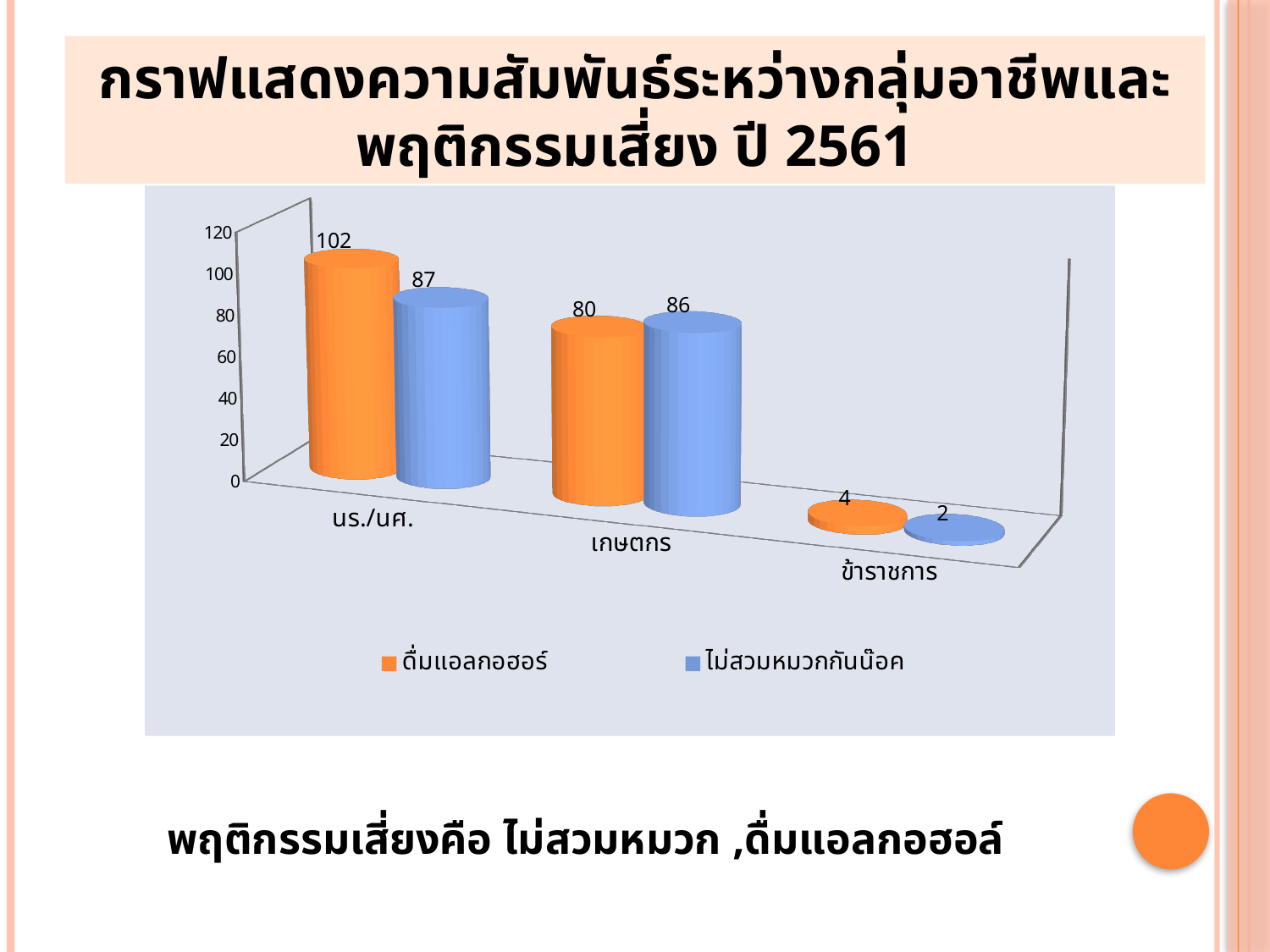
Which category has the lowest value for ไม่สวมหมวกกันน๊อค? ข้าราชการ What kind of chart is shown on the slide? bar chart What is the value for ดื่มแอลกอฮอร์ in the นร./นศ. category? 102 Which category has the highest value for ดื่มแอลกอฮอร์? นร./นศ. How many series does the legend list? 2 What is the difference between the ดื่มแอลกอฮอร์ and ไม่สวมหมวกกันน๊อค values for นร./นศ.? 15 Is the value for ดื่มแอลกอฮอร์ in the นร./นศ. category greater or less than 100? greater In the เกษตรกร category, which series has the larger value, ดื่มแอลกอฮอร์ or ไม่สวมหมวกกันน๊อค? ไม่สวมหมวกกันน๊อค Which colour represents the ดื่มแอลกอฮอร์ series in the chart? orange What is the value for ไม่สวมหมวกกันน๊อค in the เกษตรกร category? 86 How many categories are shown on the x axis of the chart? 3 What is the value for ไม่สวมหมวกกันน๊อค in the ข้าราชการ category? 2